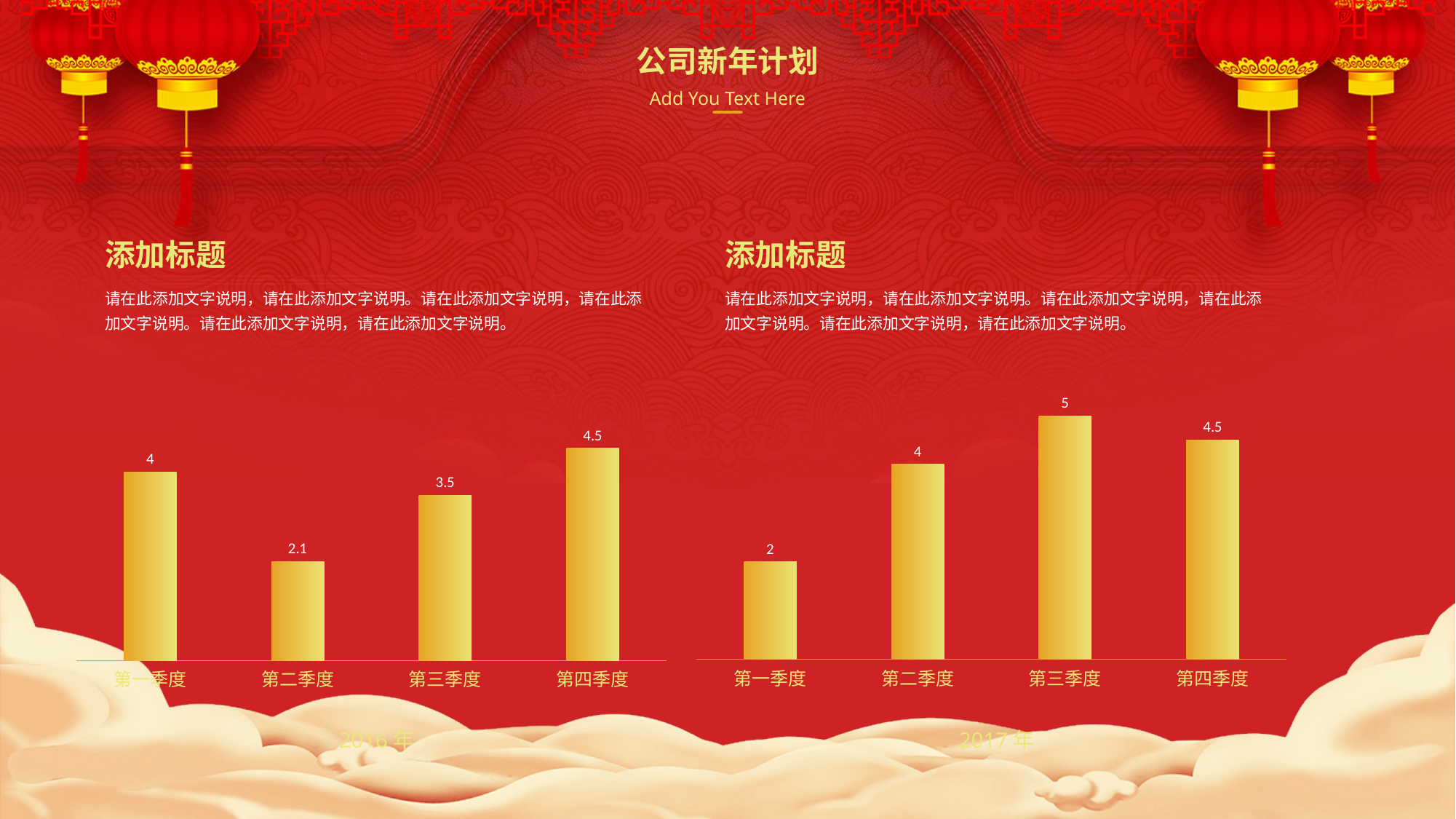
In the right chart, what is the value for 第三季度? 5 In the left chart, which is larger, the value for 第一季度 or 第三季度? 第一季度 How many categories does the left chart show? 4 In the left chart, what is the difference between the values for 第四季度 and 第二季度? 2.4 What kind of chart is the right chart? bar chart In the left chart, which quarter has the highest value? 第四季度 In the left chart, what is the value for 第二季度? 2.1 In the right chart, do the values rise or fall from 第一季度 to 第三季度? rise In the right chart, which quarter has the lowest value? 第一季度 In the right chart, what is the difference between the values for 第三季度 and 第一季度? 3 In the left chart, what is the value for 第一季度? 4 In the right chart, which is larger, the value for 第二季度 or 第四季度? 第四季度